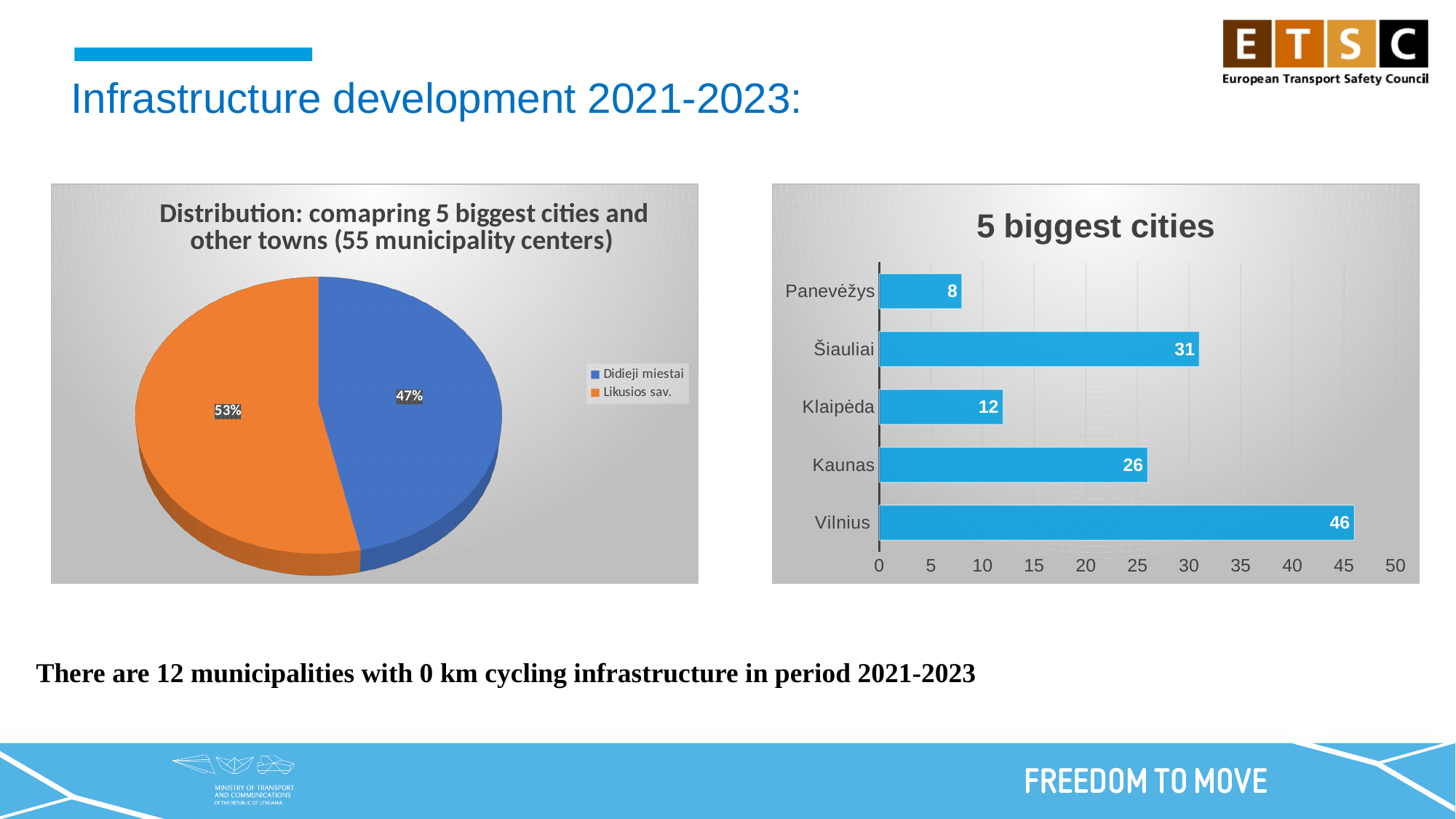
In the '5 biggest cities' chart, what is the value for Vilnius? 46 In the pie chart on the left, which slice is larger, 'Didieji miestai' or 'Likusios sav.'? Likusios sav. In the pie chart on the left, what share does 'Didieji miestai' have? 47% What kind of chart is the '5 biggest cities' chart? Bar chart In the '5 biggest cities' chart, which city has the lowest value? Panevėžys In the '5 biggest cities' chart, which is larger, the value for Kaunas or the value for Klaipėda? Kaunas In the pie chart on the left, what share does 'Likusios sav.' have? 53% In the '5 biggest cities' chart, what is the difference between the values for Šiauliai and Kaunas? 5 How many cities are shown in the '5 biggest cities' chart? 5 In the '5 biggest cities' chart, which city has the highest value? Vilnius In the '5 biggest cities' chart, what is the value for Klaipėda? 12 How many entries does the legend of the pie chart on the left list? 2